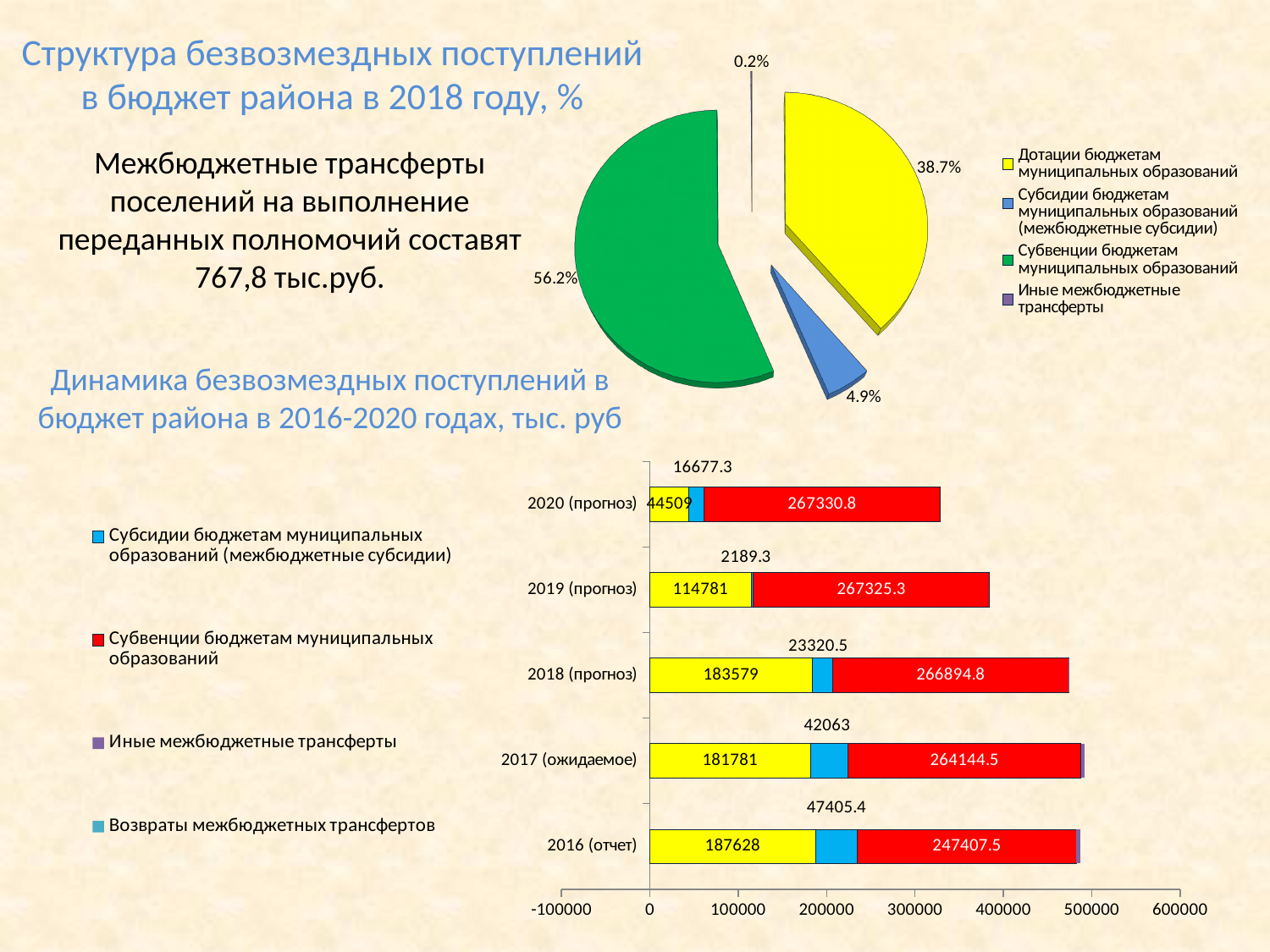
In the pie chart 'Структура безвозмездных поступлений в бюджет района в 2018 году, %', which category has the smallest slice? Иные межбюджетные трансферты In the pie chart 'Структура безвозмездных поступлений в бюджет района в 2018 году, %', which category has the largest slice? Субвенции бюджетам муниципальных образований In the chart 'Динамика безвозмездных поступлений в бюджет района в 2016-2020 годах, тыс. руб', what is the value of Субсидии бюджетам муниципальных образований for 2020 (прогноз)? 16677.3 How many year categories are shown in the chart 'Динамика безвозмездных поступлений в бюджет района в 2016-2020 годах, тыс. руб'? 5 In the chart 'Динамика безвозмездных поступлений в бюджет района в 2016-2020 годах, тыс. руб', which year has the larger Субсидии value: 2017 (ожидаемое) or 2018 (прогноз)? 2017 (ожидаемое) In the chart 'Динамика безвозмездных поступлений в бюджет района в 2016-2020 годах, тыс. руб', do the Субвенции бюджетам муниципальных образований values rise or fall from 2016 (отчет) to 2020 (прогноз)? Rise In the chart 'Динамика безвозмездных поступлений в бюджет района в 2016-2020 годах, тыс. руб', what is the value of Субвенции бюджетам муниципальных образований for 2016 (отчет)? 247407.5 What kind of chart is 'Динамика безвозмездных поступлений в бюджет района в 2016-2020 годах, тыс. руб'? Stacked bar chart In the pie chart 'Структура безвозмездных поступлений в бюджет района в 2018 году, %', what share is shown for Дотации бюджетам муниципальных образований? 38.7% In the chart 'Динамика безвозмездных поступлений в бюджет района в 2016-2020 годах, тыс. руб', what is the difference between the Субвенции values for 2020 (прогноз) and 2016 (отчет)? 19923.3 How many entries does the legend of the pie chart 'Структура безвозмездных поступлений в бюджет района в 2018 году, %' list? 4 In the pie chart 'Структура безвозмездных поступлений в бюджет района в 2018 году, %', what share is shown for Субвенции бюджетам муниципальных образований? 56.2%